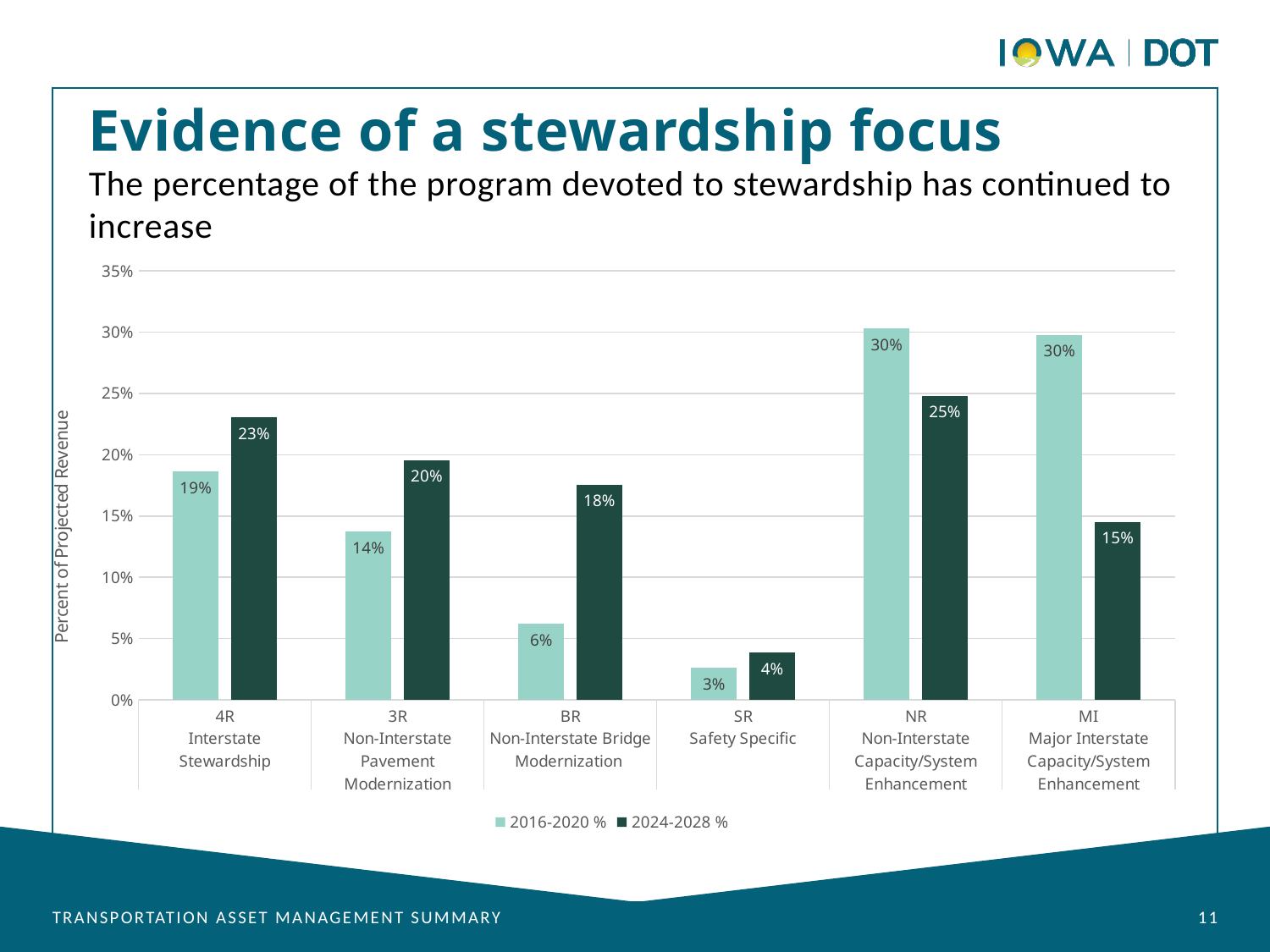
Which category has the highest 2024-2028 % value? NR Non-Interstate Capacity/System Enhancement What is the 2024-2028 % value for 4R Interstate Stewardship? 23% Is the 2016-2020 % value for NR Non-Interstate Capacity/System Enhancement greater or less than 25%? greater What is the 2024-2028 % value for MI Major Interstate Capacity/System Enhancement? 15% Which is larger for 3R Non-Interstate Pavement Modernization: the 2016-2020 % value or the 2024-2028 % value? 2024-2028 % How many categories are shown on the x axis? 6 What is the 2016-2020 % value for BR Non-Interstate Bridge Modernization? 6% What is the difference between the 2024-2028 % and 2016-2020 % values for BR Non-Interstate Bridge Modernization? 12% What kind of chart is shown on the slide? Bar chart How many series does the legend list? 2 What is the label of the vertical axis? Percent of Projected Revenue Which category has the lowest 2016-2020 % value? SR Safety Specific